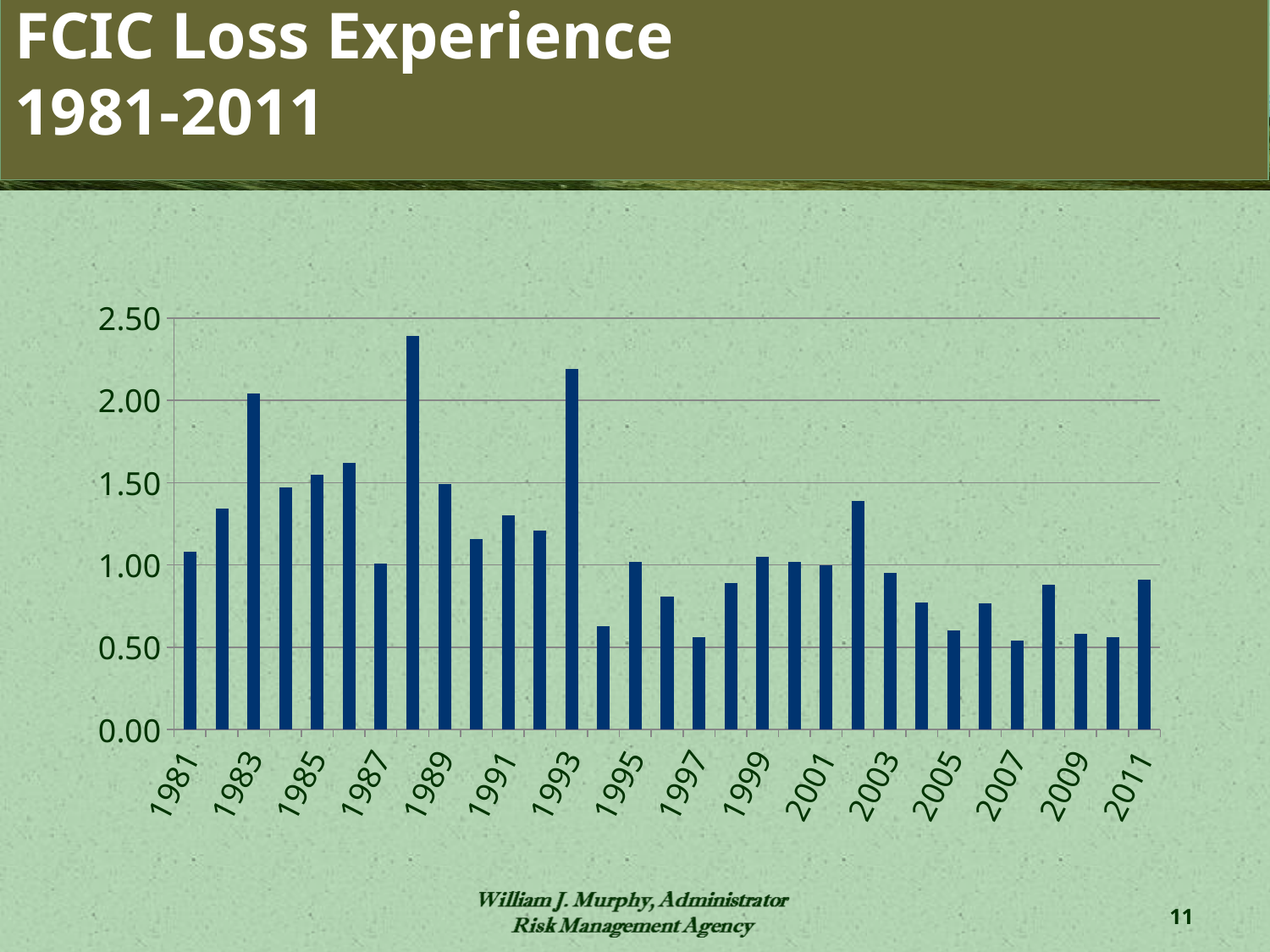
Is the value for 1997 greater or less than 1.00? less Is the value for 2011 greater or less than 1.00? less Is the value for 2007 greater or less than 1.00? less What is the title of the slide containing the chart? FCIC Loss Experience 1981-2011 How many bars (years) are plotted in the chart? 31 Which year has the larger value, 1993 or 2011? 1993 Overall, do the values tend to rise or fall from the 1980s to the 2000s? Fall What kind of chart is shown on the slide? Bar chart Which year has the larger value, 1983 or 1997? 1983 Which year has the larger value, 2005 or 1991? 1991